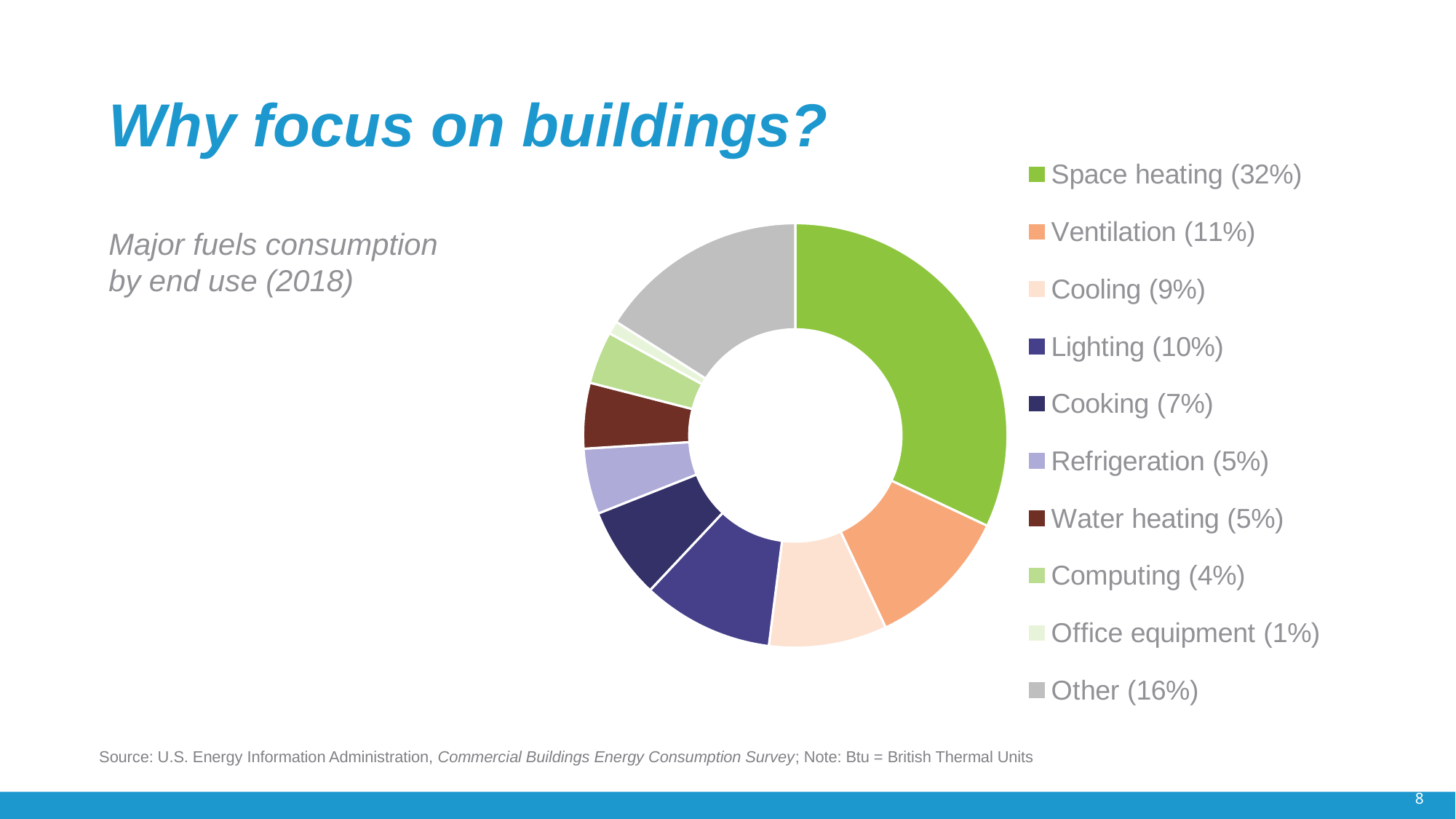
What colour is the Space heating slice? Green What share of major fuels consumption by end use is Space heating? 32% What is the difference in percentage points between Space heating and Other? 16 Which is larger, the share for Cooking or the share for Computing? Cooking What is the difference in percentage points between Ventilation and Cooling? 2 Which end use has the smallest share of major fuels consumption? Office equipment What kind of chart is shown on the slide? Pie chart (doughnut) What percentage is shown for Office equipment? 1% What percentage is shown for Lighting? 10% Which end use has the largest share of major fuels consumption? Space heating How many end-use categories does the legend list? 10 What share of the pie does Ventilation account for? 11%